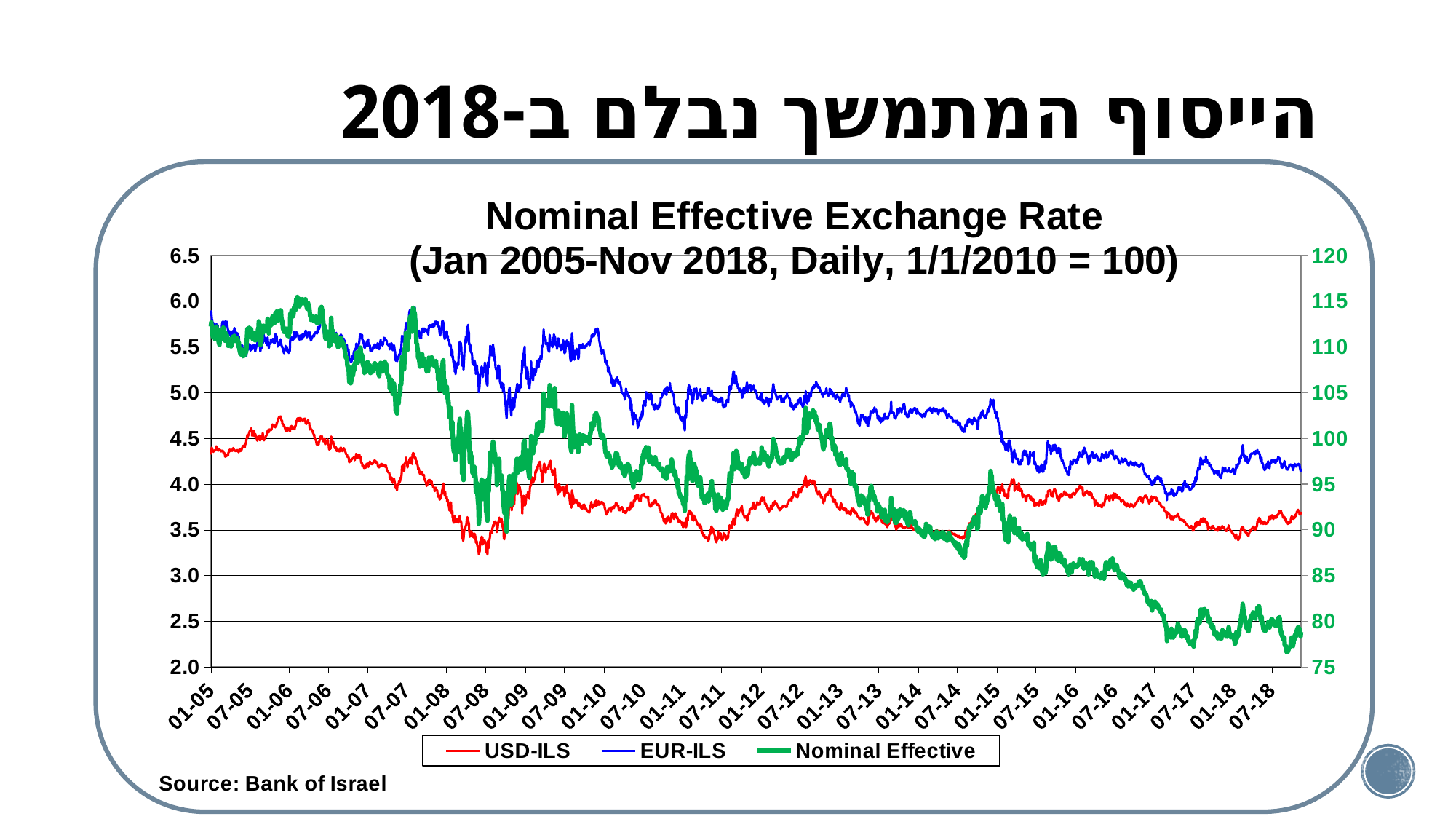
How many series does the legend list? 3 What kind of chart is shown on the slide? Line chart Does the EUR-ILS series rise or fall overall from 01-05 to 07-18? Fall Is the value for USD-ILS at 01-05 greater or less than 4.0? greater What is the title of the chart? Nominal Effective Exchange Rate (Jan 2005-Nov 2018, Daily, 1/1/2010 = 100) Is the value for Nominal Effective at 07-18 greater or less than 85? less What source is cited for the chart? Bank of Israel Is the value for Nominal Effective at 01-06 greater or less than 110? greater Does the Nominal Effective series rise or fall overall from 01-05 to 07-18? Fall Which series is higher throughout the chart, EUR-ILS or USD-ILS? EUR-ILS